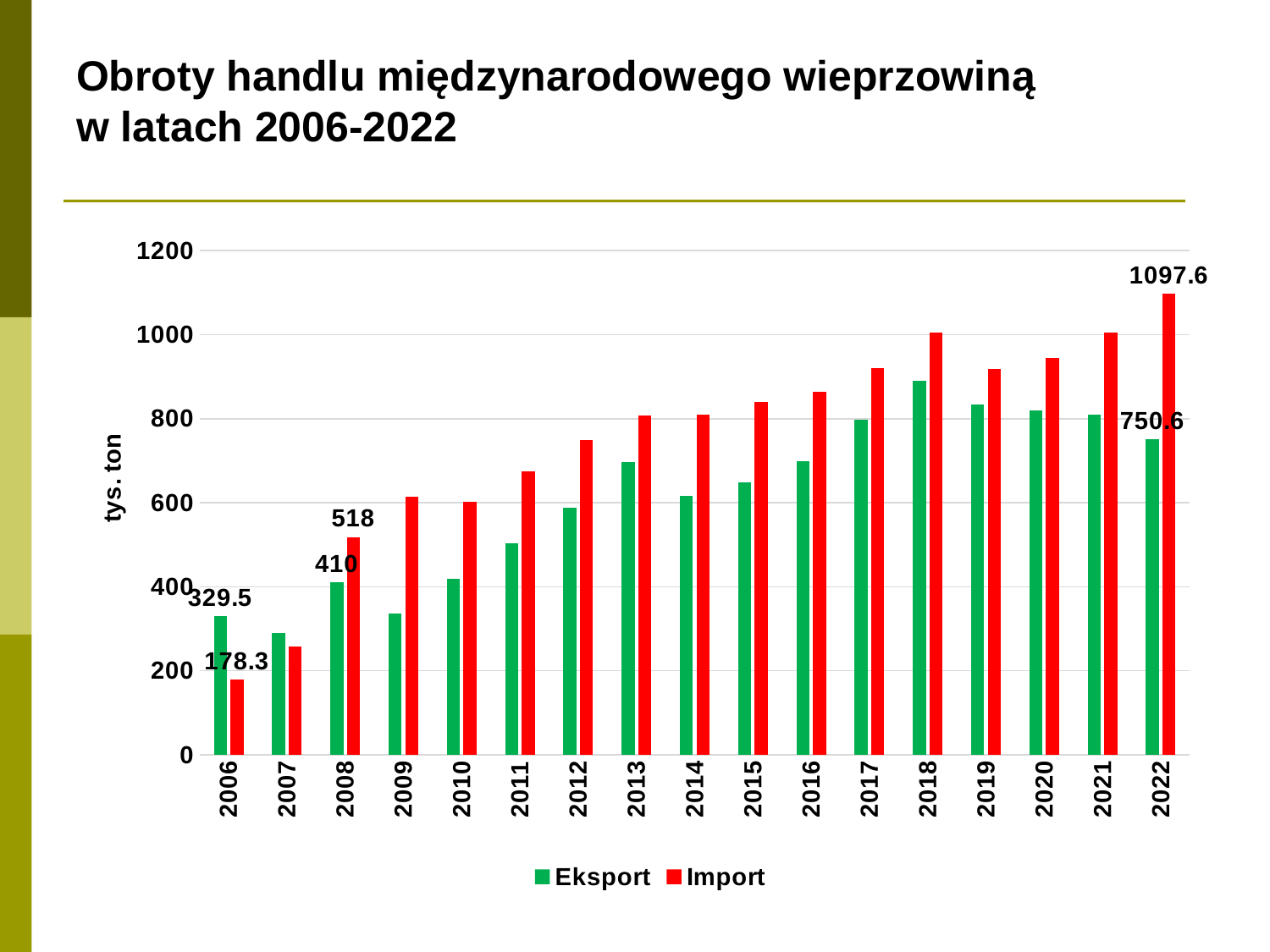
Is the Import value for 2017 greater or less than 1000? less How many series does the legend list? 2 What is the Eksport value for 2006? 329.5 What is the Eksport value for 2022? 750.6 What is the difference between Eksport and Import in 2006? 151.2 In 2006, which is larger, Eksport or Import? Eksport In which year is the Import value highest? 2022 What is the Import value for 2008? 518 What is the Import value for 2022? 1097.6 What is the difference between Import and Eksport in 2022? 347 How many years are shown on the x axis? 17 In which year is the Import value lowest? 2006